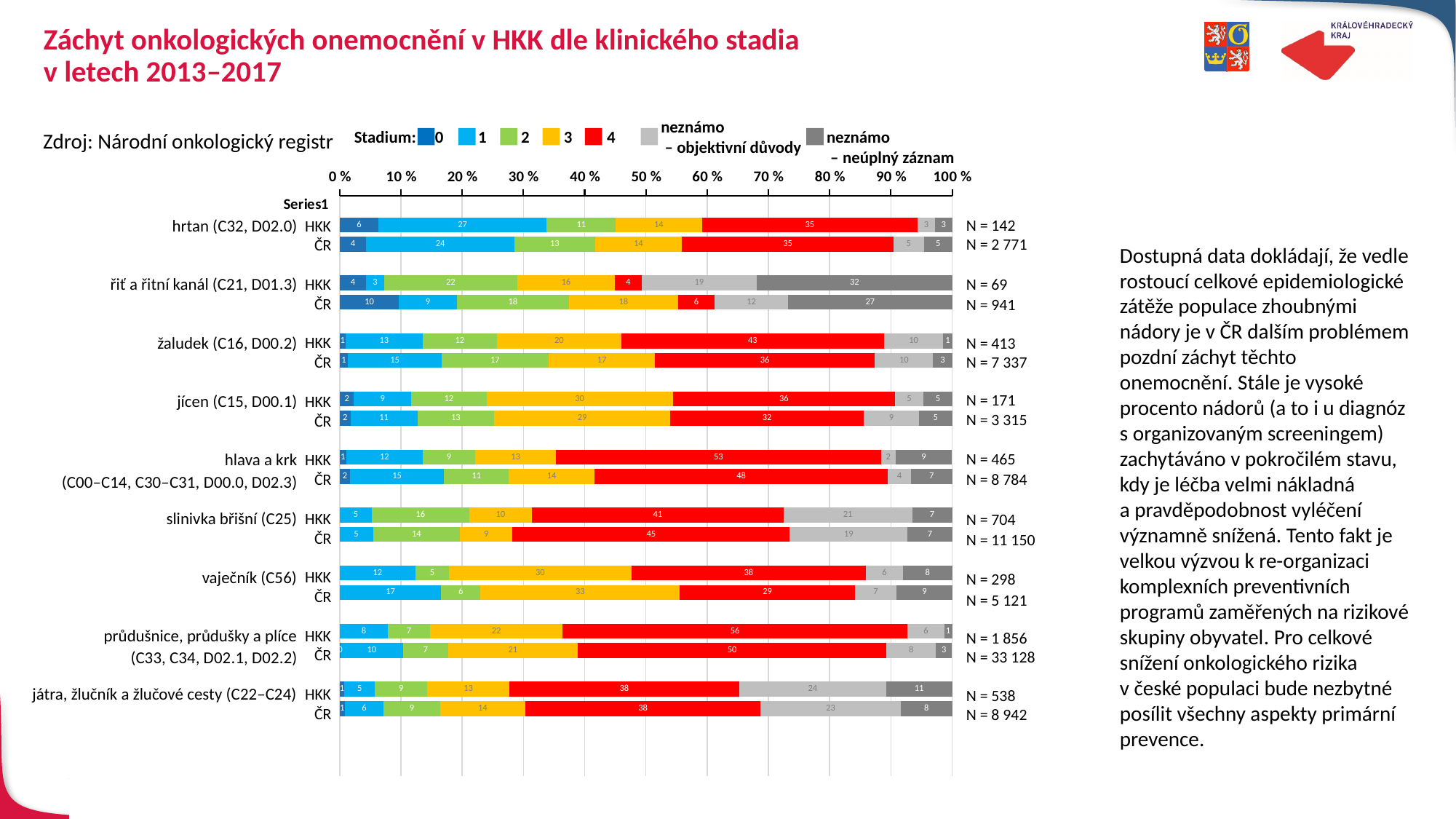
How many diagnosis groups are shown in the chart? 9 How many stage categories (series) does the legend list? 7 What is the labelled value for stadium 4 in the HKK bar for hlava a krk (C00–C14, C30–C31, D00.0, D02.3)? 53 What is the labelled value for stadium 4 in the HKK bar for průdušnice, průdušky a plíce (C33, C34, D02.1, D02.2)? 56 What is the labelled value for 'neznámo – neúplný záznam' in the HKK bar for řiť a řitní kanál (C21, D01.3)? 32 What data source is cited for the chart? Národní onkologický registr For slinivka břišní (C25), is the stadium 4 value larger for HKK or for ČR? ČR Which diagnosis has the highest stadium 4 value in its HKK bar? průdušnice, průdušky a plíce (C33, C34, D02.1, D02.2) What is the labelled value for stadium 3 in the ČR bar for vaječník (C56)? 33 What is the difference between the stadium 1 values for hrtan (C32, D02.0) in HKK and ČR? 3 What type of chart is shown on the slide? bar chart What is the N value shown for the ČR bar of slinivka břišní (C25)? N = 11 150